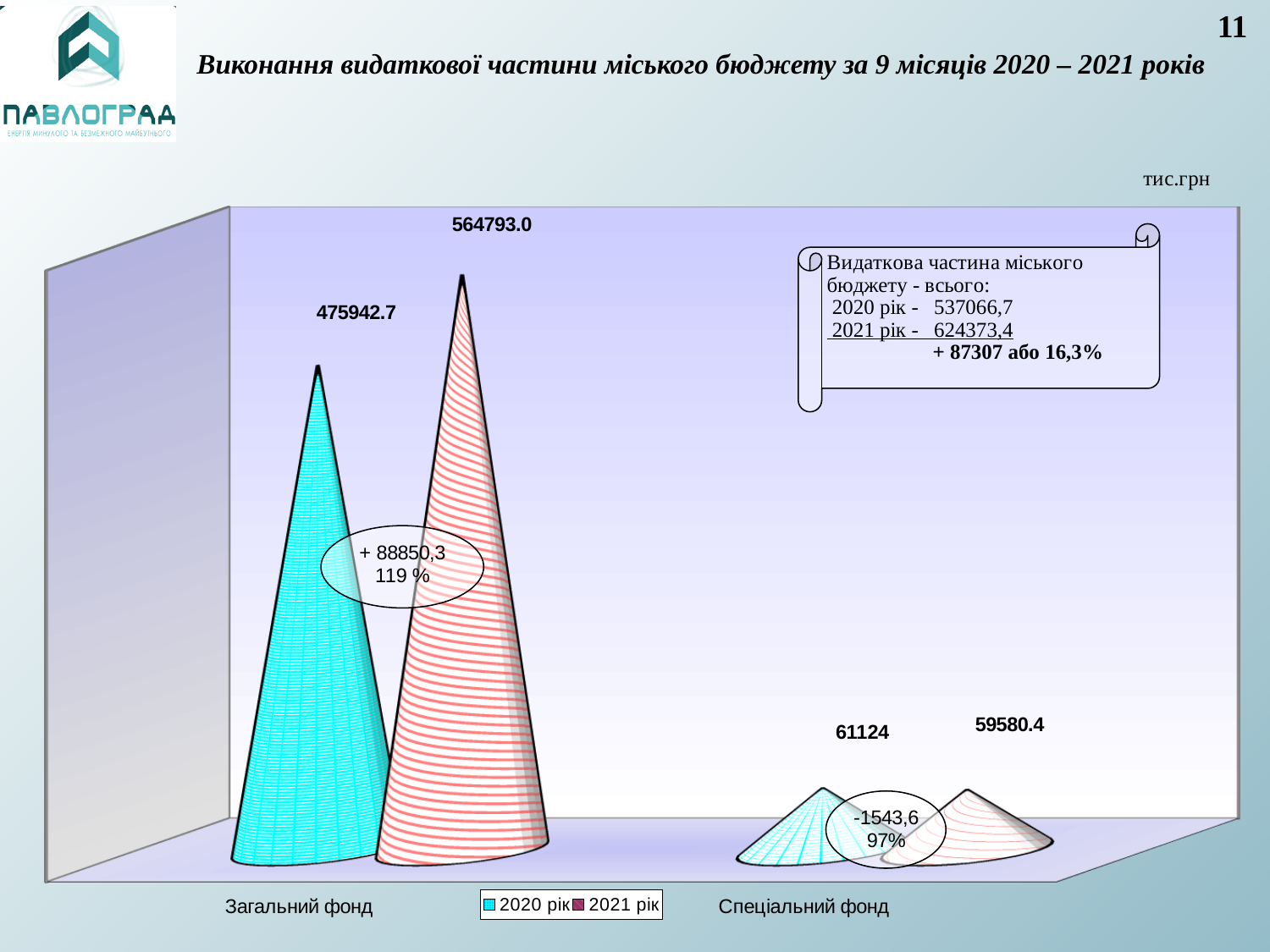
For Загальний фонд, which series has the larger value, 2020 рік or 2021 рік? 2021 рік Which category has the lowest value in the 2020 рік series? Спеціальний фонд What is the difference between the 2020 рік and 2021 рік values for Спеціальний фонд? 1543.6 What unit is indicated for the chart values? тис.грн What is the difference between the 2021 рік and 2020 рік values for Загальний фонд? 88850.3 What is the value for Загальний фонд in the 2020 рік series? 475942.7 What is the value for Спеціальний фонд in the 2021 рік series? 59580.4 How many series does the chart legend list? 2 What is the value for Загальний фонд in the 2021 рік series? 564793.0 How many categories are shown on the x axis of the chart? 2 Which category has the highest value in the 2021 рік series? Загальний фонд What is the value for Спеціальний фонд in the 2020 рік series? 61124